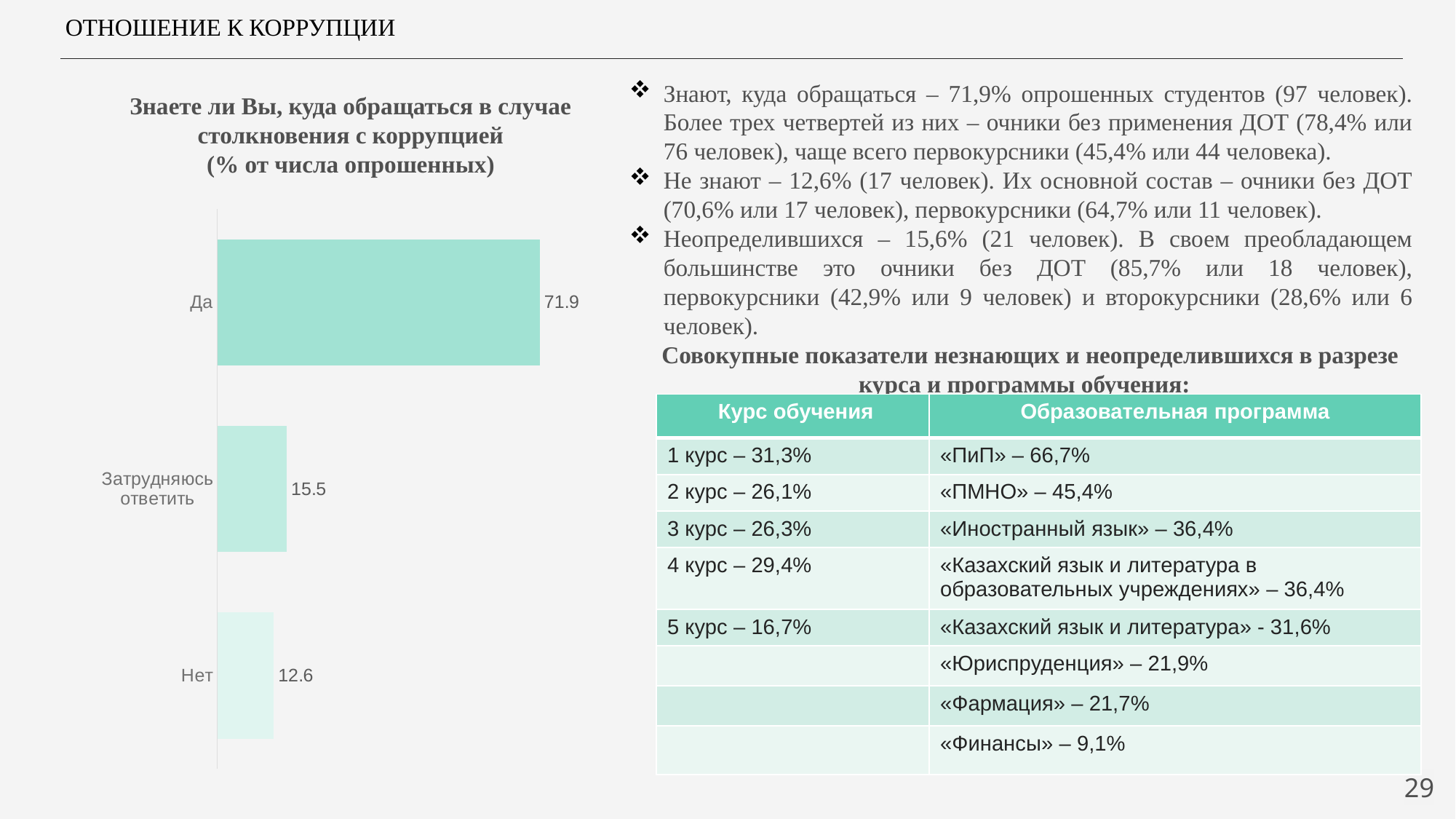
What is the value for "Да" in the chart? 71.9 Which is larger: the value for "Затрудняюсь ответить" or the value for "Нет"? Затрудняюсь ответить Which category has the highest value in the chart? Да What is the value for "Затрудняюсь ответить" in the chart? 15.5 How many categories are shown in the chart? 3 Which category has the lowest value in the chart? Нет What is the difference between the values for "Затрудняюсь ответить" and "Нет"? 2.9 What is the title of the chart? Знаете ли Вы, куда обращаться в случае столкновения с коррупцией (% от числа опрошенных) What is the value for "Нет" in the chart? 12.6 What kind of chart is shown on the slide? Bar chart What is the total of the three values shown in the chart? 100 What is the difference between the values for "Да" and "Нет"? 59.3